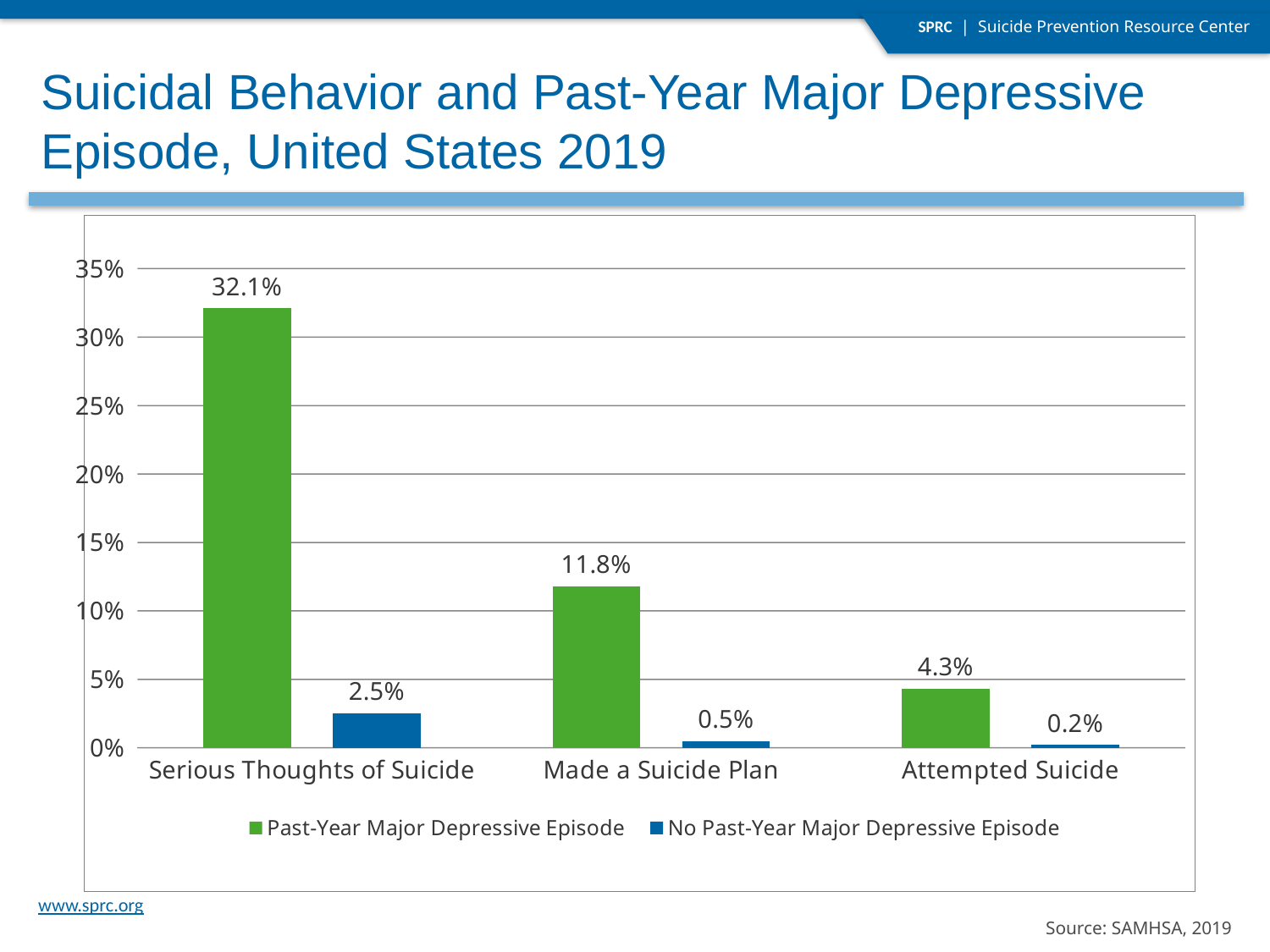
Which colour represents the No Past-Year Major Depressive Episode series? Blue How many series does the legend list? 2 What is the value for Attempted Suicide among those with a past-year major depressive episode? 4.3% Which is larger: the Past-Year Major Depressive Episode value for Made a Suicide Plan or the No Past-Year Major Depressive Episode value for Serious Thoughts of Suicide? Past-Year Major Depressive Episode value for Made a Suicide Plan How many categories are shown on the x axis? 3 What is the difference between the two series for Serious Thoughts of Suicide? 29.6% What is the value for Made a Suicide Plan among those with no past-year major depressive episode? 0.5% What is the difference between the Past-Year Major Depressive Episode values for Made a Suicide Plan and Attempted Suicide? 7.5% Which category has the lowest value for the No Past-Year Major Depressive Episode series? Attempted Suicide What kind of chart is shown on the slide? Bar chart What percentage of people with a past-year major depressive episode had serious thoughts of suicide? 32.1% Which category has the highest value for the Past-Year Major Depressive Episode series? Serious Thoughts of Suicide